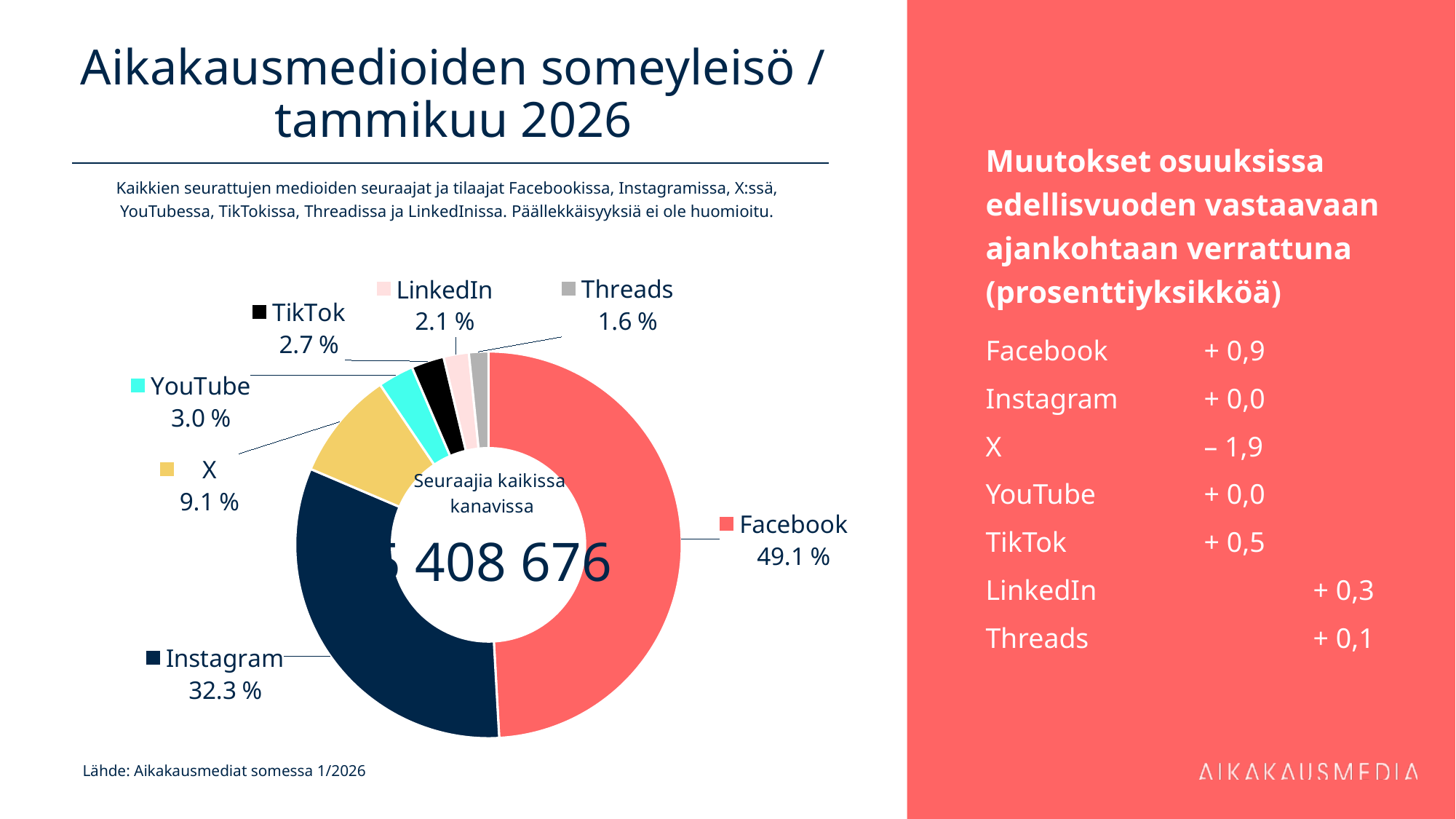
Which has a larger share, TikTok or LinkedIn? TikTok Which platform has the largest share in the chart? Facebook How many platforms are shown as slices in the chart? 7 What is the title of the slide? Aikakausmedioiden someyleisö / tammikuu 2026 What share does YouTube hold in the donut chart? 3.0 % What share does Threads hold in the donut chart? 1.6 % What share does X hold in the donut chart? 9.1 % What share of the social media audience does Instagram hold? 32.3 % What share of the social media audience does Facebook hold? 49.1 % Which platform has the smallest share in the chart? Threads How many percentage points larger is Facebook's share than Instagram's? 16.8 What type of chart is used on the slide? Donut (pie) chart